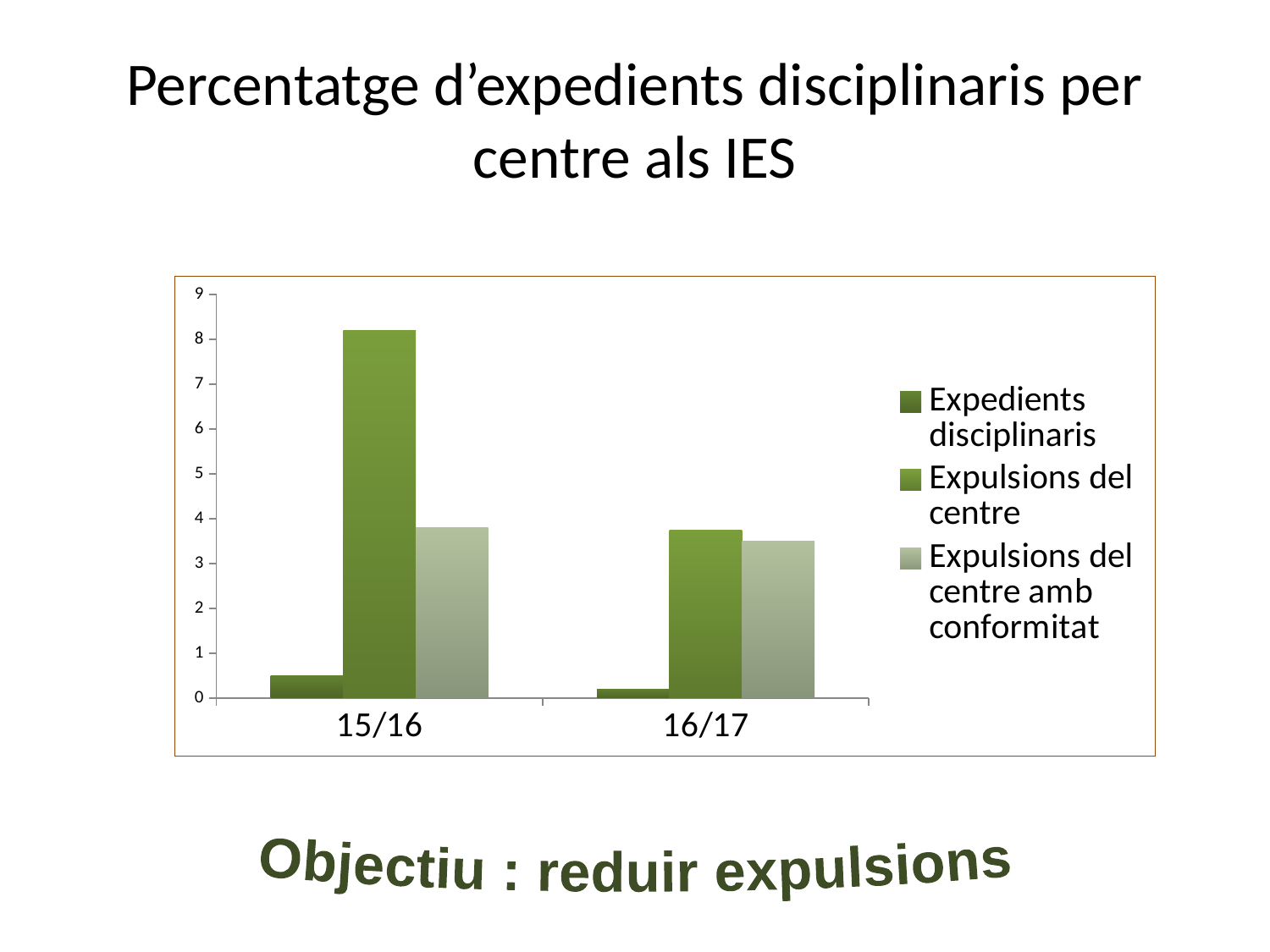
Which series has the highest value in 15/16? Expulsions del centre What kind of chart is shown on the slide? bar chart Does the value for Expulsions del centre rise or fall from 15/16 to 16/17? fall How many series does the legend list? 3 What is the title of the slide containing the chart? Percentatge d'expedients disciplinaris per centre als IES Which is larger: Expulsions del centre in 15/16 or in 16/17? 15/16 Is the value for Expedients disciplinaris in 15/16 greater or less than 1? less Is the value for Expulsions del centre amb conformitat in 16/17 greater or less than 3? greater Is the value for Expulsions del centre in 16/17 greater or less than 4? less Which series has the lowest value in 16/17? Expedients disciplinaris How many categories are shown on the x axis? 2